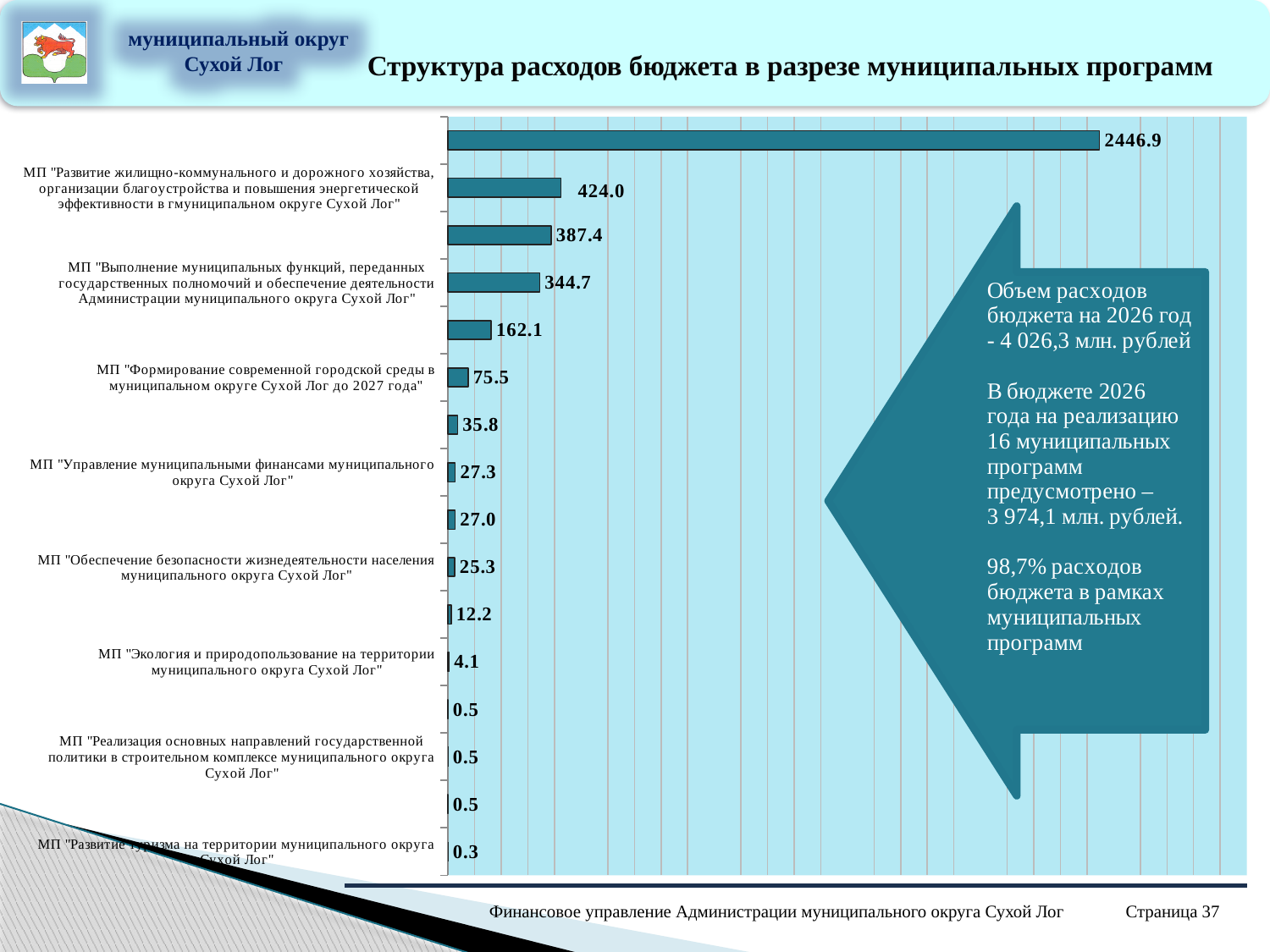
What is the value for МП "Управление муниципальными финансами муниципального округа Сухой Лог"? 27.3 What kind of chart is shown on the slide? bar chart How many bars are plotted in the chart? 16 What is the value for МП "Формирование современной городской среды в муниципальном округе Сухой Лог до 2027 года"? 75.5 What is the value for МП "Экология и природопользование на территории муниципального округа Сухой Лог"? 4.1 What is the smallest value shown in the chart? 0.3 What is the value for МП "Развитие туризма на территории муниципального округа Сухой Лог"? 0.3 What is the difference between the second-largest bar (424.0) and the third-largest bar (387.4)? 36.6 What is the difference between the largest bar (2446.9) and the second-largest bar (424.0)? 2022.9 How many bars in the chart have the value 0.5? 3 What is the title of the slide containing the chart? Структура расходов бюджета в разрезе муниципальных программ What is the largest value shown in the chart? 2446.9